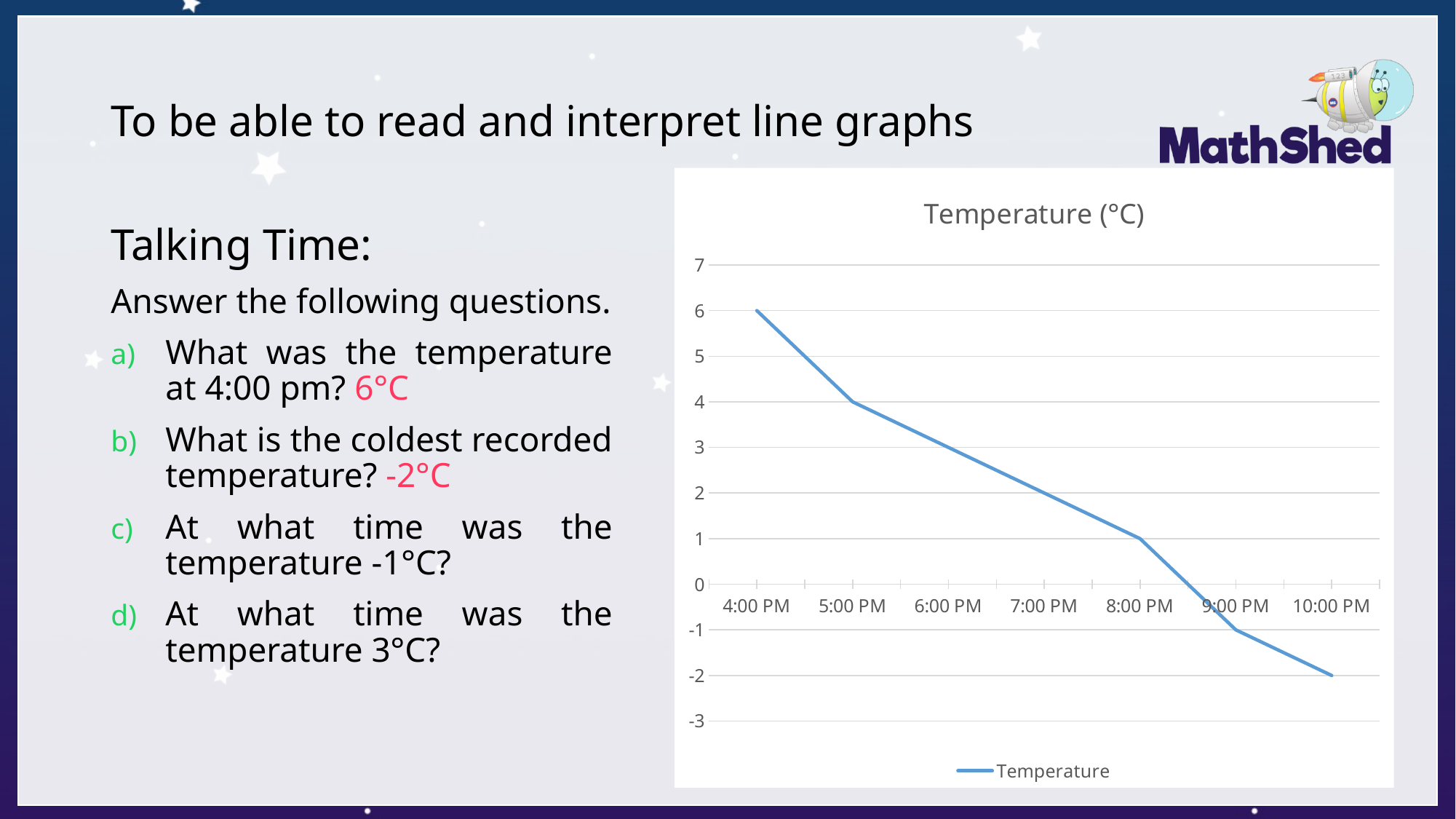
At what time was the temperature lowest? 10:00 PM At what time was the temperature -1? 9:00 PM What was the temperature at 8:00 PM? 1 At what time was the temperature highest? 4:00 PM Does the temperature rise or fall from 4:00 PM to 10:00 PM? fall How many time points are plotted on the chart? 7 Is the temperature at 9:00 PM greater or less than 0? less What is the difference between the temperature at 4:00 PM and the temperature at 10:00 PM? 8 What was the temperature at 4:00 PM? 6 Which is higher, the temperature at 5:00 PM or at 8:00 PM? 5:00 PM What was the temperature at 10:00 PM? -2 What kind of chart is shown on the slide? line chart